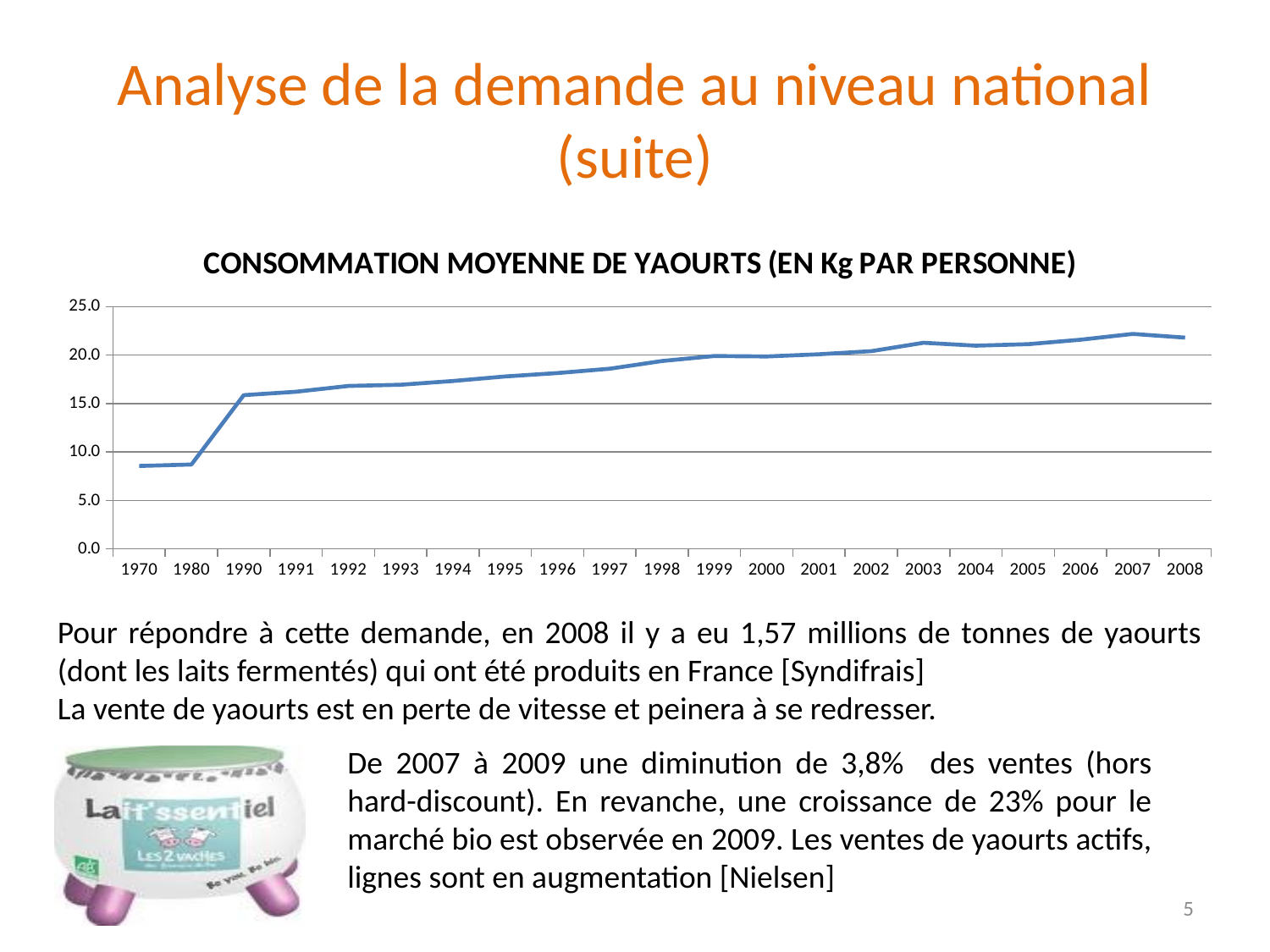
Does the average yogurt consumption generally rise or fall from 1970 to 2008? rise How many years are shown on the x axis of the chart? 21 Which year has the larger value, 1992 or 2005? 2005 Is the value for 1995 greater or less than 20.0? less Is the value for 2003 greater or less than 20.0? greater Is the value for 1990 greater or less than 15.0? greater What kind of chart is shown on the slide? line chart Which year has the highest average yogurt consumption in the chart? 2007 What is the title of the chart? CONSOMMATION MOYENNE DE YAOURTS (EN Kg PAR PERSONNE) Which year has the larger value, 1980 or 1990? 1990